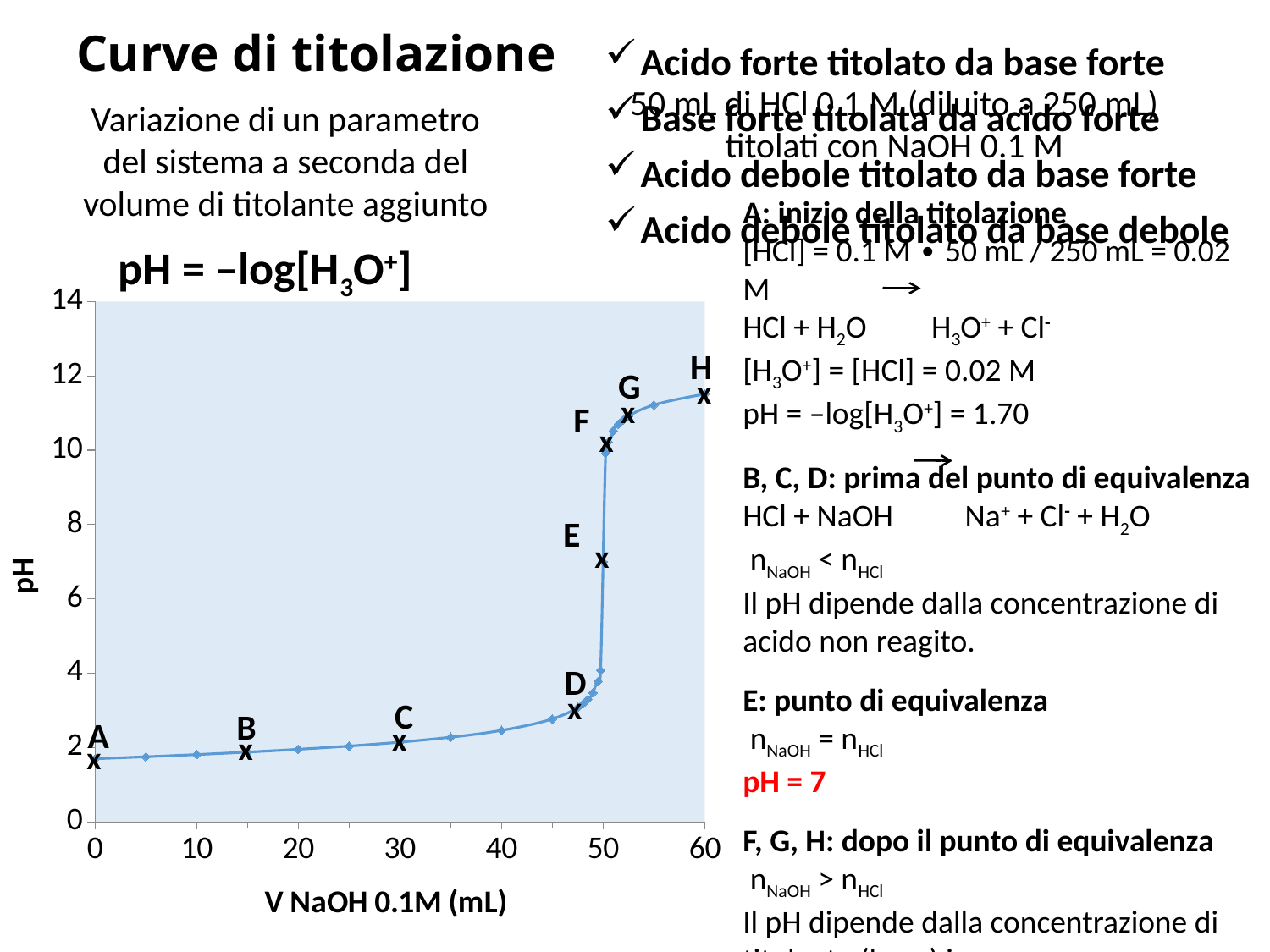
What is the label of the y axis of the chart? pH What is the label of the x axis of the chart? V NaOH 0.1M (mL) How many labeled points (A to H) are marked on the curve? 8 Is the pH at point C greater or less than 4? less What kind of chart is shown on the slide? line chart Which point has a higher pH, G or B? G At what volume of NaOH (mL) is point A located? 0 Is the pH at point H greater or less than 10? greater Which labeled point has the lowest pH? A Is the pH at point A greater or less than 2? less Does the pH rise or fall as the volume of NaOH increases along the x axis? rise Which labeled point has the highest pH? H